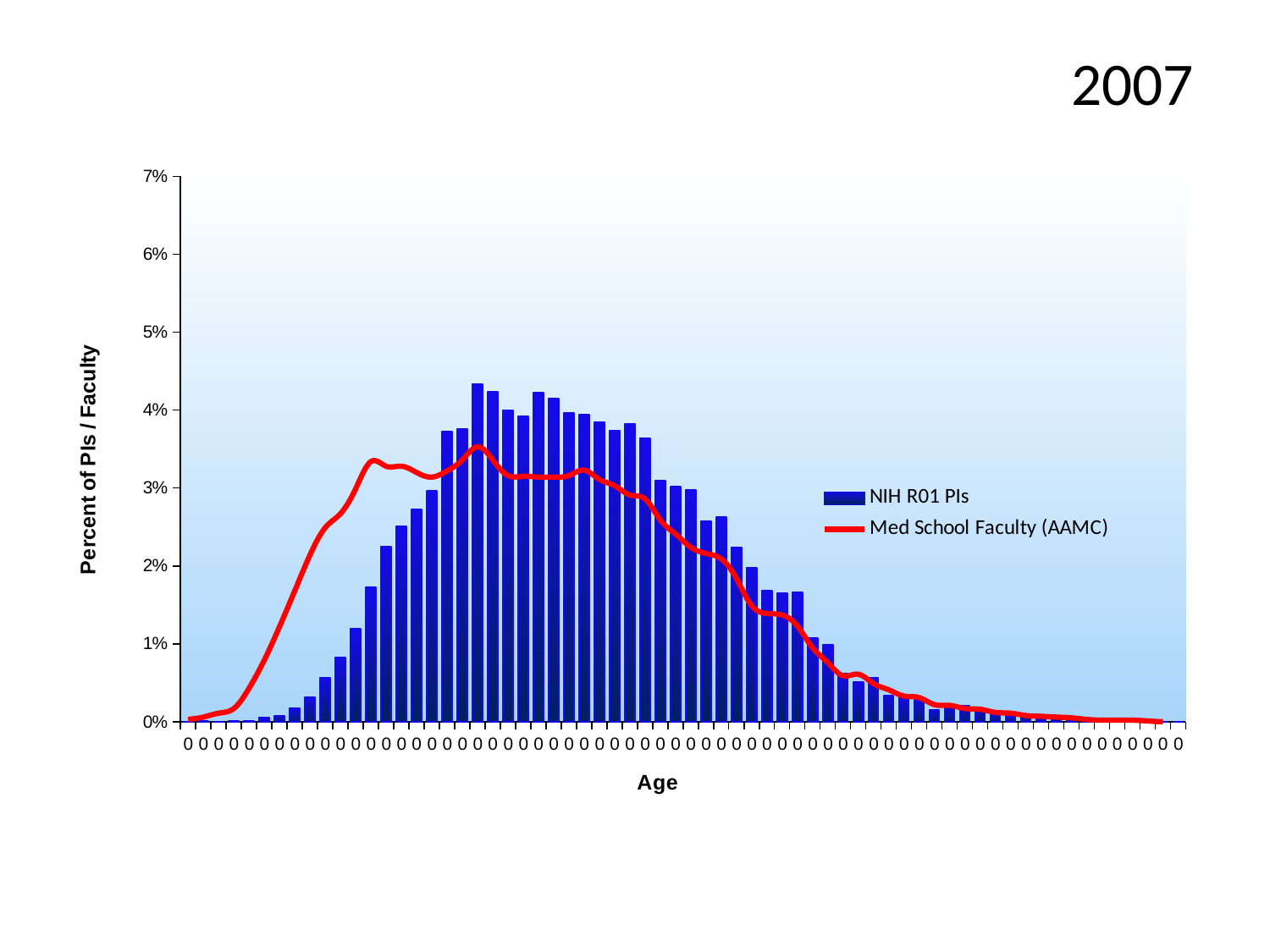
Is the highest point of the Med School Faculty (AAMC) line greater or less than 4%? less Which series is drawn as a red line? Med School Faculty (AAMC) What is the label on the horizontal axis? Age Is the tallest NIH R01 PIs bar greater or less than 4%? greater Toward the right end of the x axis, do the NIH R01 PIs bars rise or fall? fall What are the two series named in the legend? NIH R01 PIs and Med School Faculty (AAMC) How many series does the legend list? 2 Is the tallest NIH R01 PIs bar greater or less than 5%? less Which reaches a higher peak value, the NIH R01 PIs bars or the Med School Faculty (AAMC) line? NIH R01 PIs